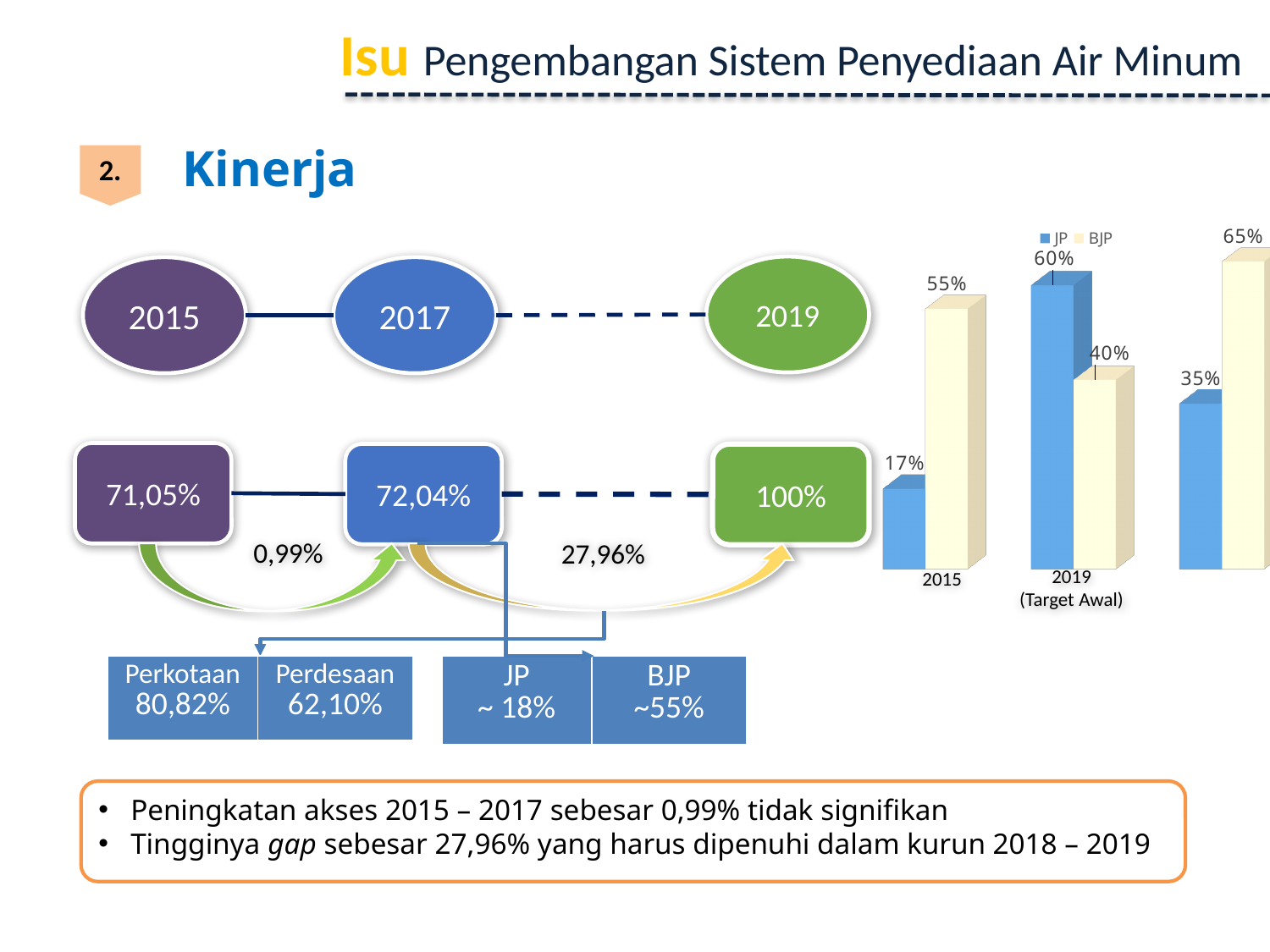
How many series does the legend of the bar chart list? 2 In the bar chart, what is the BJP value for 2015? 55% In the bar chart, what is the difference between the JP and BJP values for 2019 (Target Awal)? 20% In the bar chart, what is the BJP value for 2019 (Target Awal)? 40% In the bar chart, what is the JP value for 2015? 17% In the bar chart, what is the JP value for 2019 (Target Awal)? 60% In the bar chart, does the JP value rise or fall from 2015 to 2019 (Target Awal)? rise What are the two series names shown in the legend of the bar chart? JP and BJP What kind of chart is shown on the right of the slide? bar chart In the bar chart, which is larger for 2015, JP or BJP? BJP In the bar chart, what is the difference between the BJP and JP values for 2015? 38% In the bar chart, which is larger for 2019 (Target Awal), JP or BJP? JP